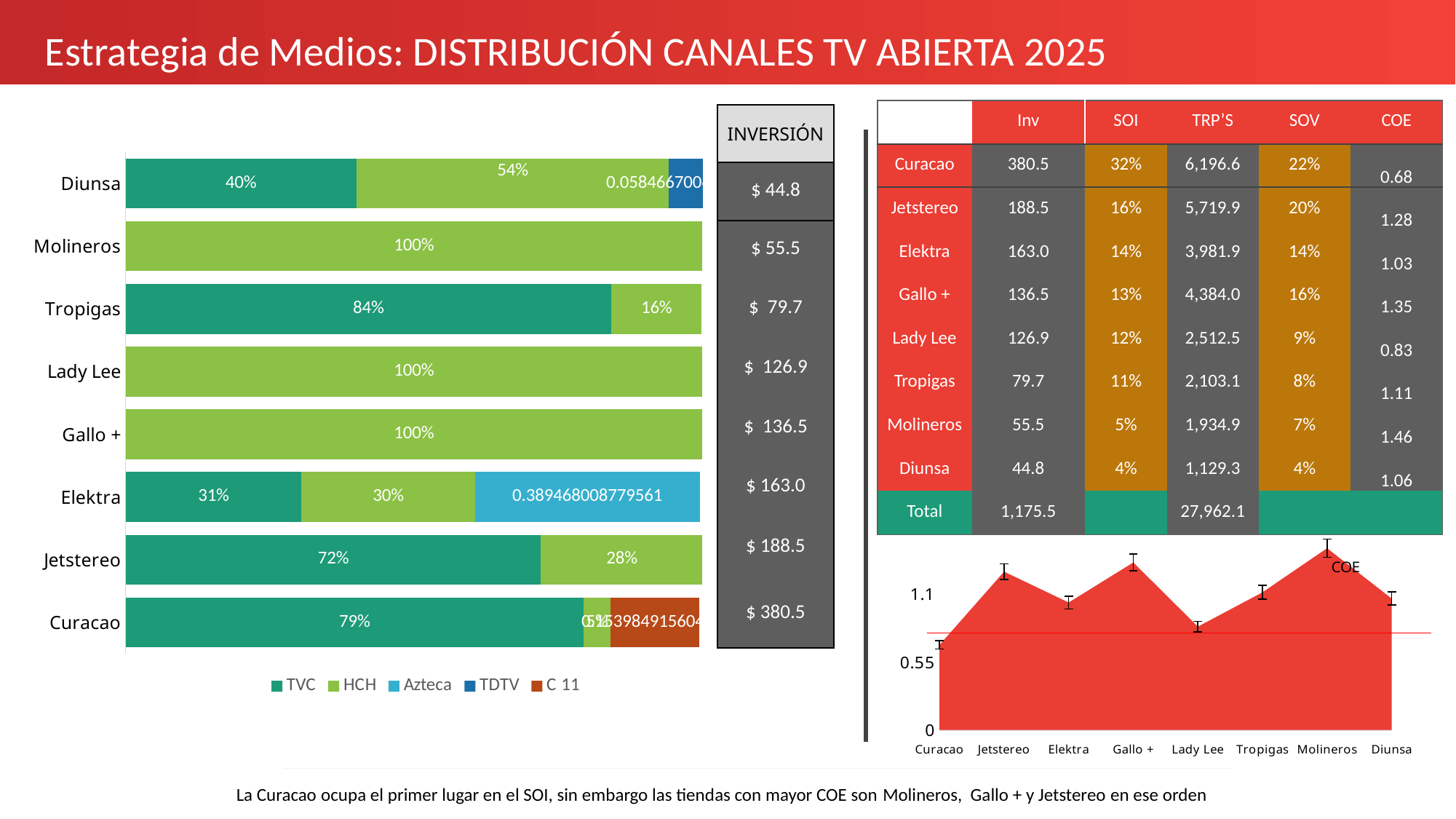
In the COE chart at the bottom right, is the value for Lady Lee greater or less than 1.1? less In the stacked bar chart on the left, what is the HCH value for Diunsa? 54% In the stacked bar chart on the left, which is larger, the TVC value for Tropigas or the TVC value for Jetstereo? Tropigas In the stacked bar chart on the left, how many series does the legend list? 5 In the stacked bar chart on the left, what is the HCH value for Jetstereo? 28% In the COE chart at the bottom right, which category has the highest value? Molineros In the stacked bar chart on the left, what is the TVC value for Tropigas? 84% What kind of chart is the chart on the left of the slide? bar chart In the stacked bar chart on the left, what is the difference between the TVC and HCH values for Tropigas? 68% In the COE chart at the bottom right, is the value for Gallo + greater or less than 1.1? greater In the COE chart at the bottom right, which category has the lowest value? Curacao In the stacked bar chart on the left, how many categories are shown? 8